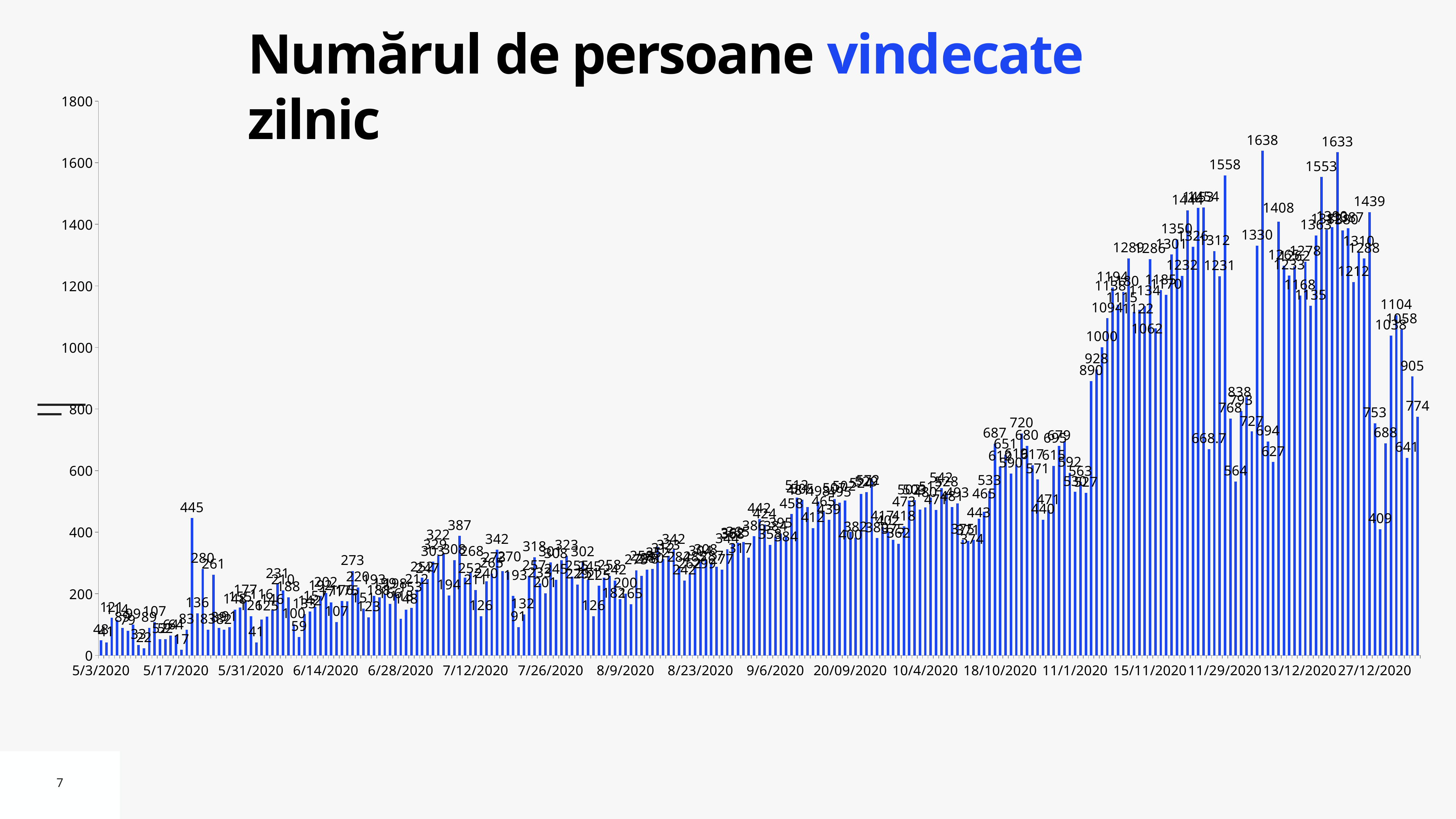
Which is larger, the bar labelled 1638 or the bar labelled 1633? 1638 What is the difference between the bars labelled 1558 and 1553? 5 Is the value of the first bar at 5/3/2020 greater or less than 200? less What is the value of the last (rightmost) bar on the chart? 774 Overall, do the values rise or fall from May 2020 to December 2020? rise What is the highest value labelled on the chart? 1638 What is the value of the tallest bar in the May 2020 section of the chart (between 5/17/2020 and 5/31/2020)? 445 Is the value of the bar at 11/1/2020 greater or less than 800? less What kind of chart is shown on the slide? bar chart What is the title of the chart? Numărul de persoane vindecate zilnic What is the difference between the highest labelled value (1638) and the rightmost bar (774)? 864 What is the maximum value shown on the vertical axis? 1800